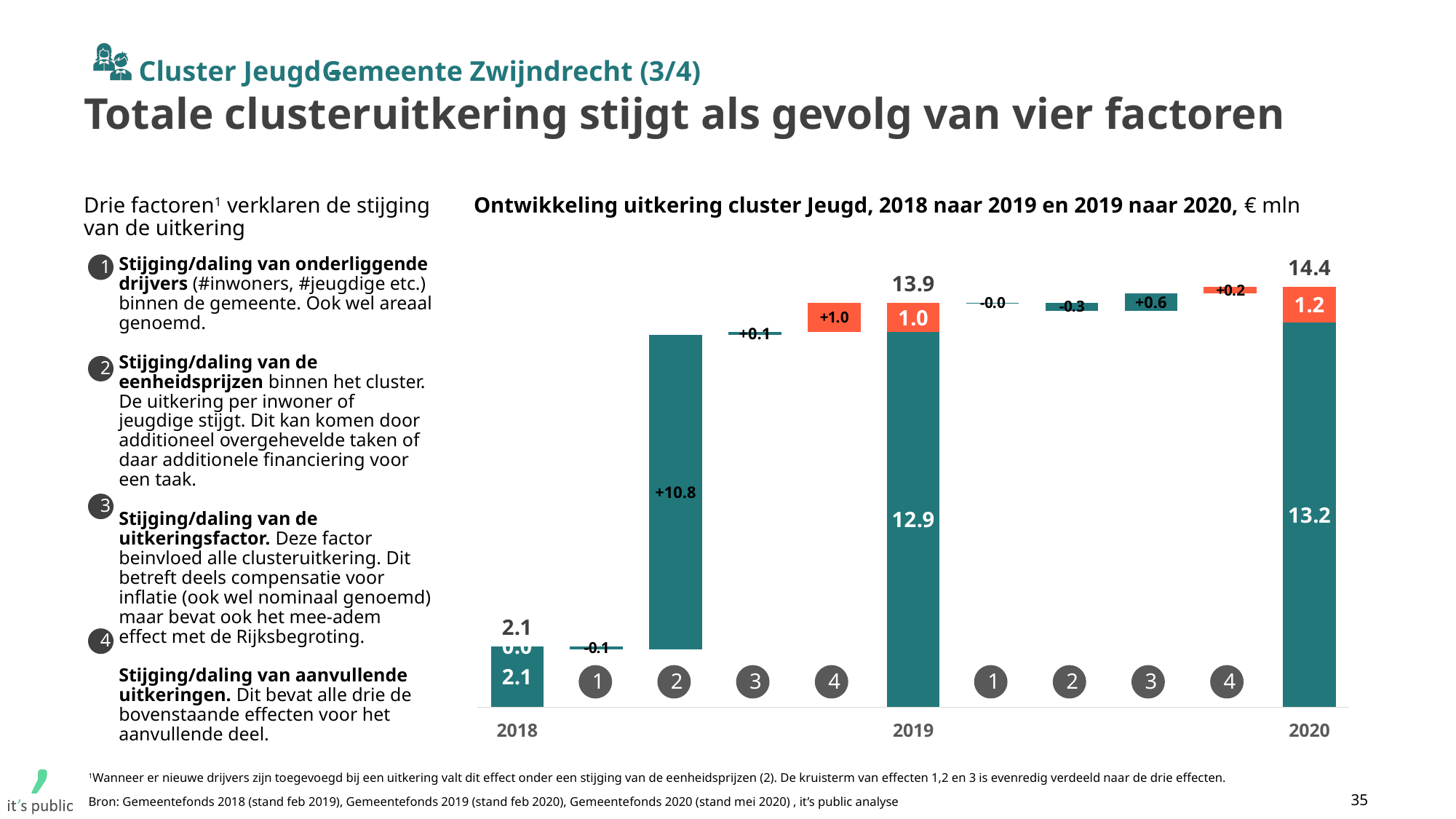
What is the value of the teal (lower) segment of the 2020 bar? 13.2 Which of the four factors has the largest effect on the change from 2018 to 2019? Factor 2 (+10.8) What is the effect of factor 4 (aanvullende uitkeringen) on the change from 2018 to 2019? +1.0 What is the total uitkering for cluster Jeugd in 2018 according to the chart? 2.1 What is the total uitkering for cluster Jeugd in 2020 according to the chart? 14.4 What is the effect of factor 2 (eenheidsprijzen) on the change from 2018 to 2019? +10.8 What is the effect of factor 3 (uitkeringsfactor) on the change from 2019 to 2020? +0.6 What is the value of the orange (upper) segment of the 2019 bar? 1.0 What is the total uitkering for cluster Jeugd in 2019 according to the chart? 13.9 What is the effect of factor 2 (eenheidsprijzen) on the change from 2019 to 2020? -0.3 By how much does the total uitkering increase from 2019 to 2020? 0.5 Does the total uitkering rise or fall from 2018 to 2020? Rise